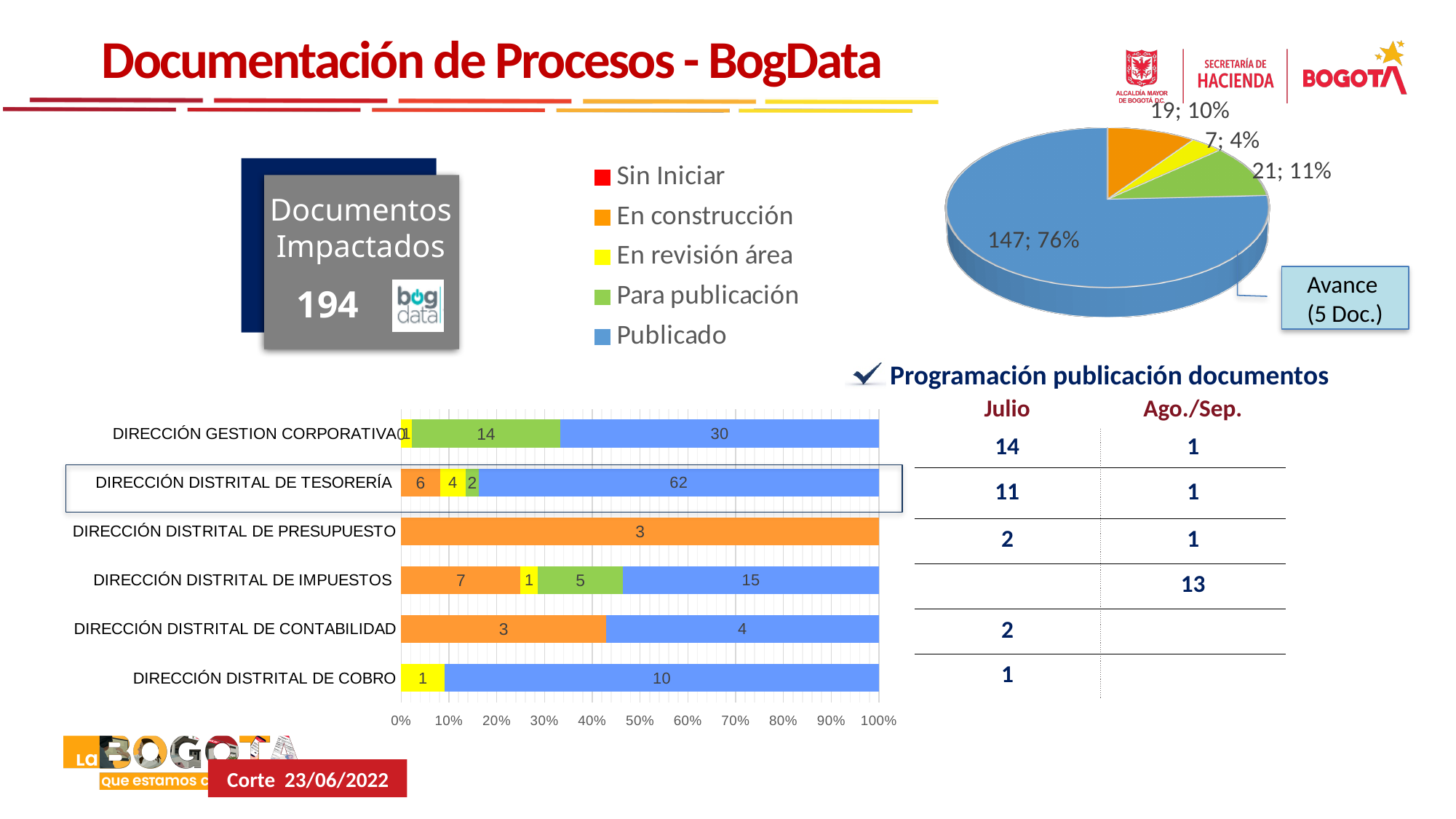
In the stacked bar chart, what is the difference between the Publicado values of DIRECCIÓN DISTRITAL DE TESORERÍA and DIRECCIÓN GESTION CORPORATIVA? 32 In the pie chart, how many documents are in the Para publicación slice? 21 In the pie chart, which category has the smallest slice? En revisión área In the stacked bar chart, how many Publicado documents does DIRECCIÓN DISTRITAL DE TESORERÍA have? 62 In the stacked bar chart, how many En construcción documents does DIRECCIÓN DISTRITAL DE IMPUESTOS have? 7 In the stacked bar chart, what is the total number of documents for DIRECCIÓN DISTRITAL DE IMPUESTOS? 28 In the stacked bar chart, how many directorates (categories) are listed? 6 In the pie chart, what value and share are shown for the Publicado slice? 147; 76% In the stacked bar chart, what is the total number of documents for DIRECCIÓN GESTION CORPORATIVA? 45 In the pie chart, what share does the En construcción slice represent? 10% What type of chart is shown at the bottom left of the slide? Stacked bar chart How many series does the legend list? 5